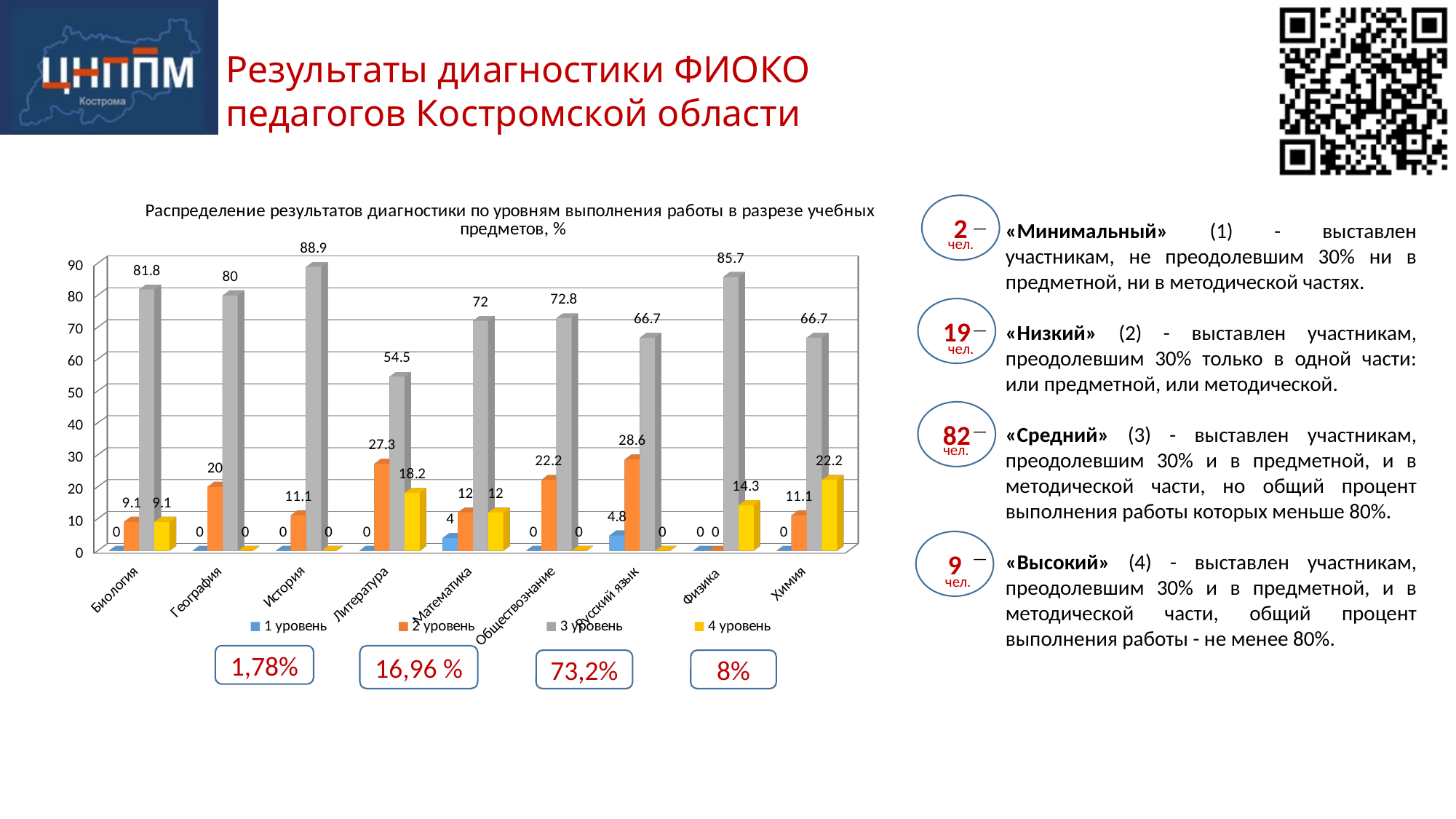
What is the value of 2 уровень for Русский язык? 28.6 Which is larger, the 2 уровень value for Литература or for Русский язык? Русский язык What is the value of 3 уровень for История? 88.9 How many subjects are shown on the x axis of the chart? 9 How many series does the chart legend list? 4 What is the value of 4 уровень for Химия? 22.2 Which subject has the highest value for 3 уровень? История What is the value of 1 уровень for Математика? 4 Which subject has the highest value for 4 уровень? Химия Which subject has the lowest value for 3 уровень? Литература What is the difference between the 3 уровень values for История and Литература? 34.4 What type of chart is shown on the slide? Bar chart